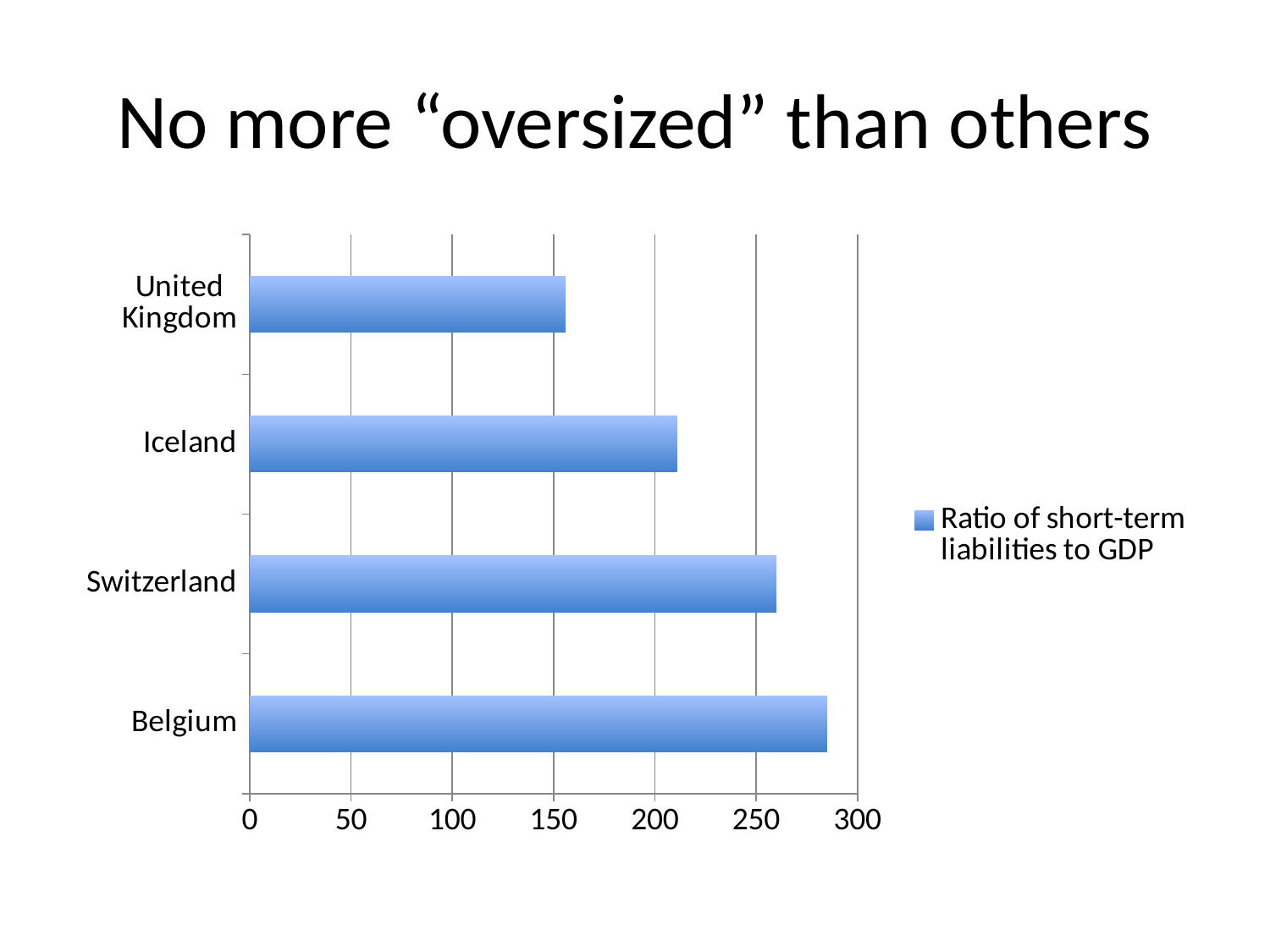
How many countries are shown in the chart? 4 Which country has the lowest ratio of short-term liabilities to GDP? United Kingdom How many series does the legend list? 1 Which country has the highest ratio of short-term liabilities to GDP? Belgium What series name does the legend show? Ratio of short-term liabilities to GDP Which has a larger ratio of short-term liabilities to GDP, the United Kingdom or Belgium? Belgium Is the value for Belgium greater or less than 300? less What kind of chart is shown on the slide? bar chart Is the value for Iceland greater or less than 200? greater Which has a larger ratio of short-term liabilities to GDP, Iceland or Switzerland? Switzerland Is the value for the United Kingdom greater or less than 200? less